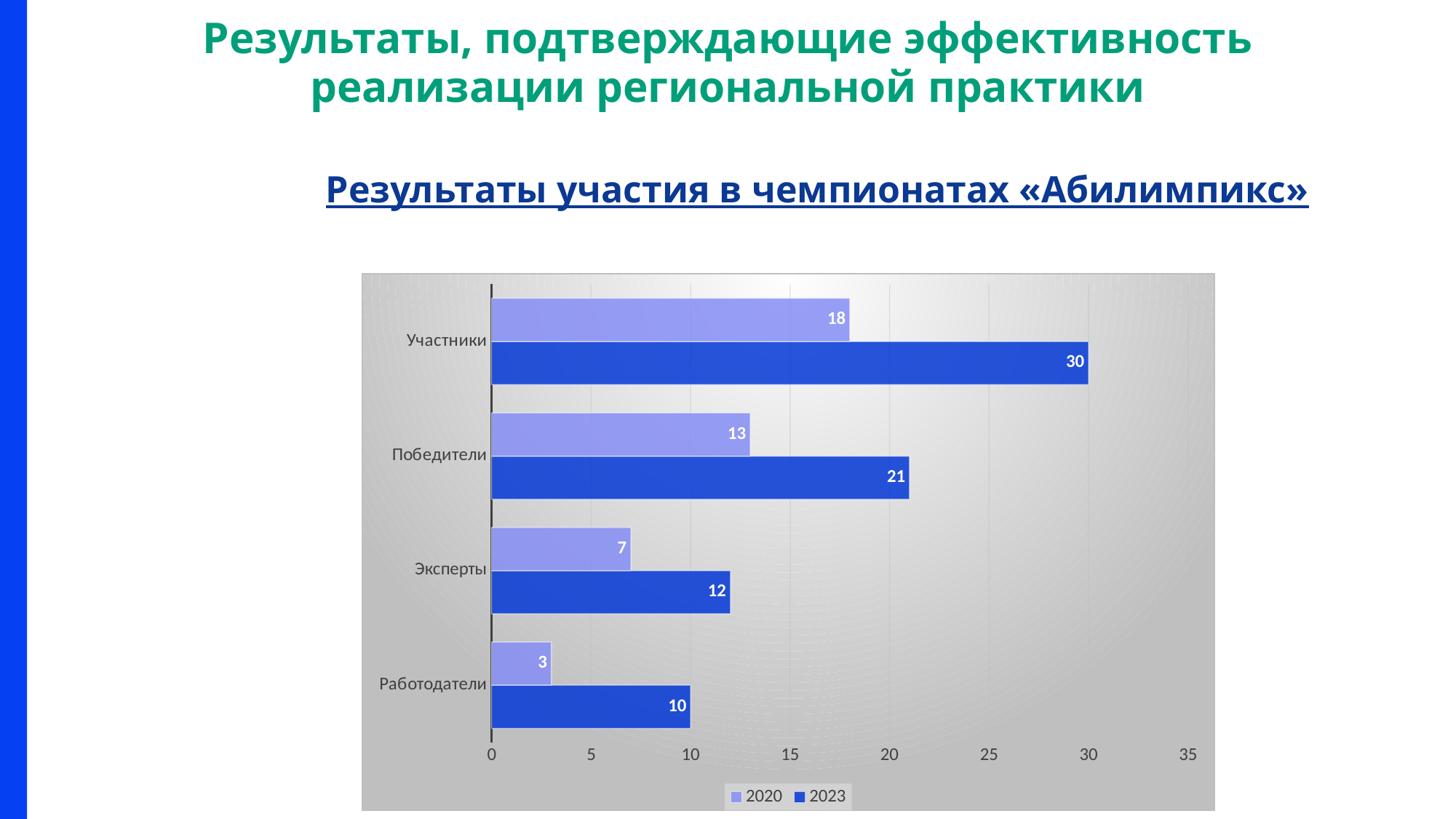
How many series does the legend list? 2 Which is larger: the 2020 value for Победители or the 2023 value for Эксперты? 2020 value for Победители What is the value for Участники in the 2023 series? 30 What is the difference between the 2023 and 2020 values for Победители? 8 What are the two series listed in the legend? 2020 and 2023 What is the value for Эксперты in the 2023 series? 12 What is the difference between the 2023 and 2020 values for Участники? 12 How many categories are shown on the chart? 4 What is the value for Работодатели in the 2020 series? 3 Which category has the highest value in the 2020 series? Участники What kind of chart is shown on the slide? Bar chart Which category has the lowest value in the 2023 series? Работодатели